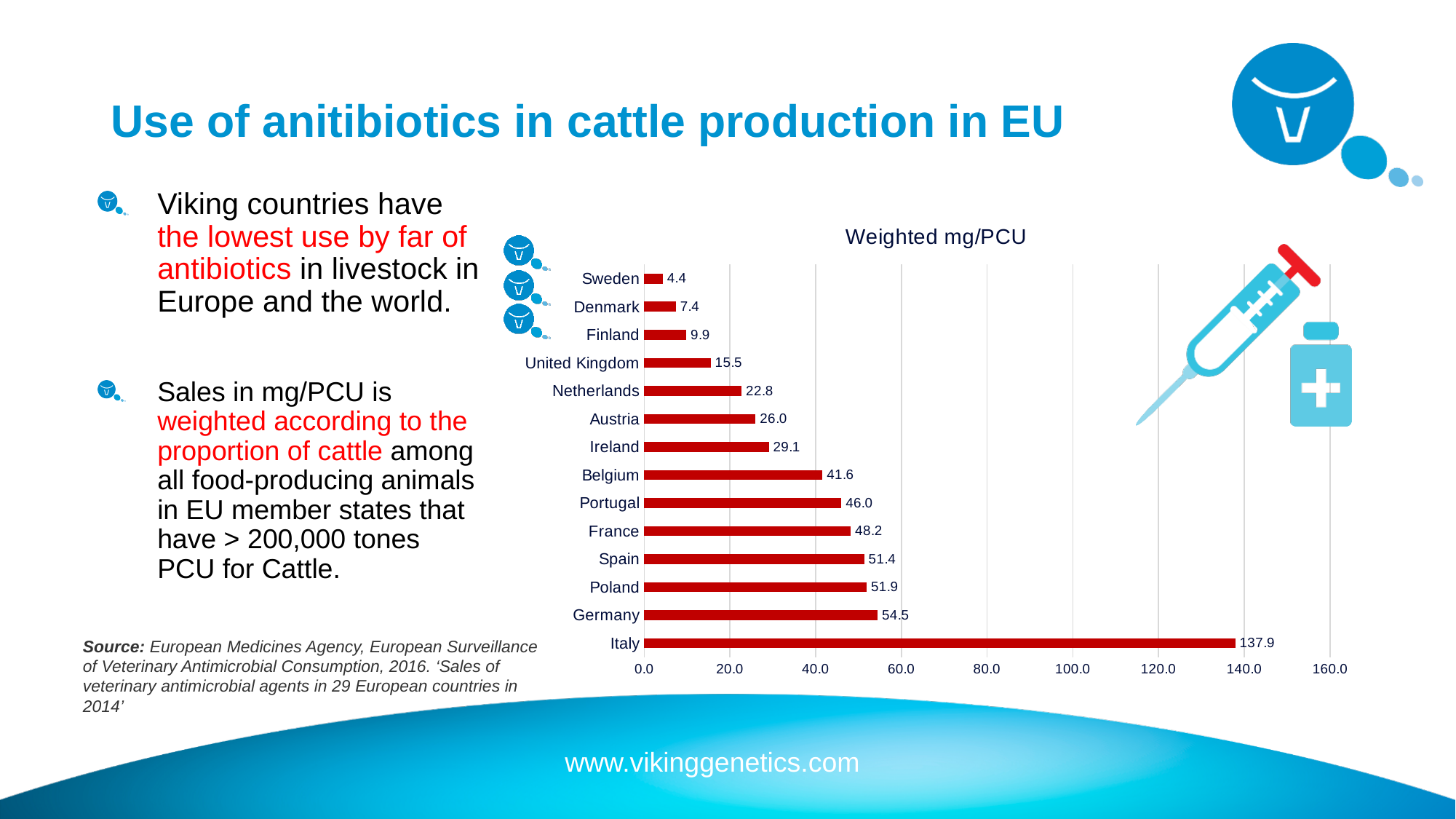
What is the difference between the values for Italy and Germany? 83.4 What kind of chart is shown on the slide? Bar chart Is the value for Italy greater or less than 120.0? greater Which country has the highest weighted mg/PCU value? Italy What is the difference between the values for Finland and Denmark? 2.5 How many countries are shown in the chart? 14 Which country has the lowest weighted mg/PCU value? Sweden What is the weighted mg/PCU value for Sweden? 4.4 What is the title of the chart? Weighted mg/PCU What is the weighted mg/PCU value for Germany? 54.5 Which has a higher weighted mg/PCU value, Belgium or Ireland? Belgium What is the weighted mg/PCU value for the Netherlands? 22.8